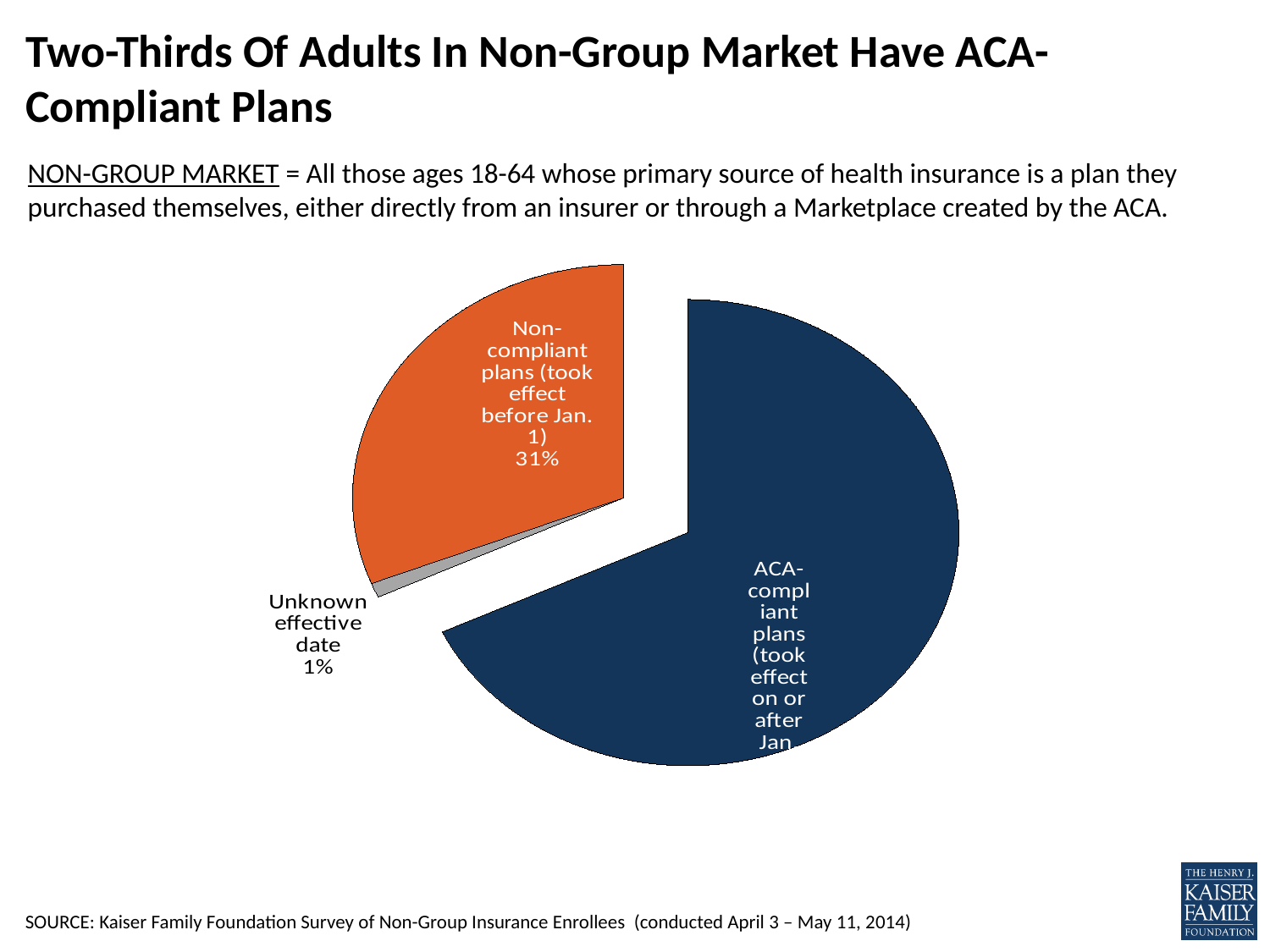
What percentage of the non-group market has non-compliant plans (took effect before Jan. 1)? 31% What colour is the slice for non-compliant plans? Orange What colour is the slice for ACA-compliant plans? Dark blue How many slices does the pie chart have? 3 What percentage of the non-group market has an unknown effective date? 1% How many percentage points larger is the non-compliant plans slice than the unknown effective date slice? 30 percentage points What kind of chart is shown on the slide? Pie chart Which slice of the pie chart is the smallest? Unknown effective date Which is larger: the share with ACA-compliant plans or the share with non-compliant plans? ACA-compliant plans Which is larger: the share with non-compliant plans or the share with an unknown effective date? Non-compliant plans Which slice of the pie chart is the largest? ACA-compliant plans (took effect on or after Jan. 1)